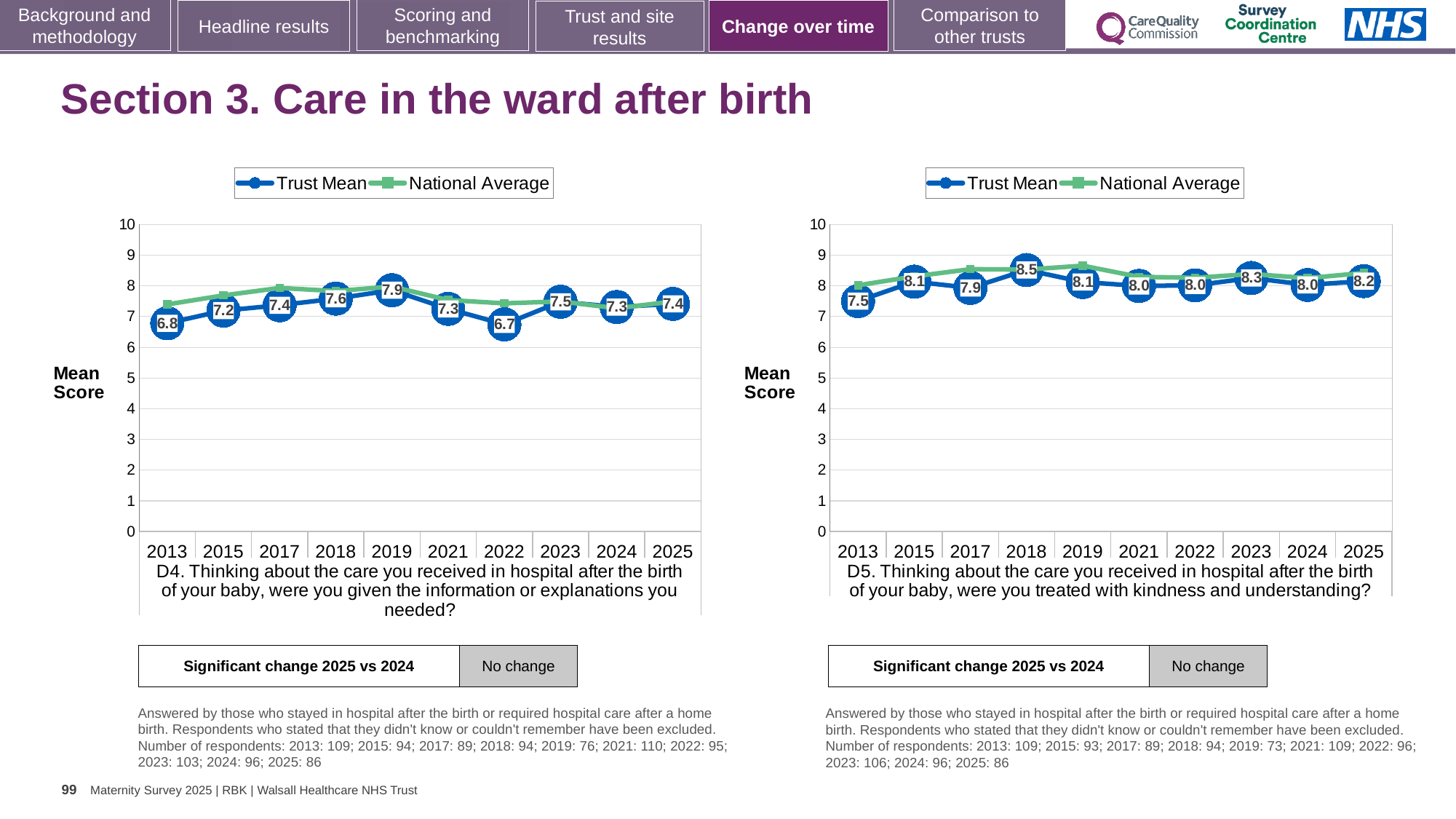
On the right chart (D5), which year has the highest Trust Mean score? 2018 On the right chart (D5), is the Trust Mean score for 2013 greater or less than 8? less On the left chart (D4), which year has the lowest Trust Mean score? 2022 On the left chart (D4), what is the difference between the Trust Mean scores for 2019 and 2022? 1.2 On the right chart (D5), what is the Trust Mean score for 2018? 8.5 On the right chart (D5), which is larger, the Trust Mean for 2023 or the Trust Mean for 2024? 2023 How many years are plotted on the left chart (D4)? 10 On the left chart (D4), what is the Trust Mean score for 2022? 6.7 On the left chart (D4), what is the Trust Mean score for 2019? 7.9 On the left chart (D4), is the National Average for 2013 greater or less than 7? greater On the right chart (D5), what is the Trust Mean score for 2025? 8.2 How many series does the legend of the right chart (D5) list? 2